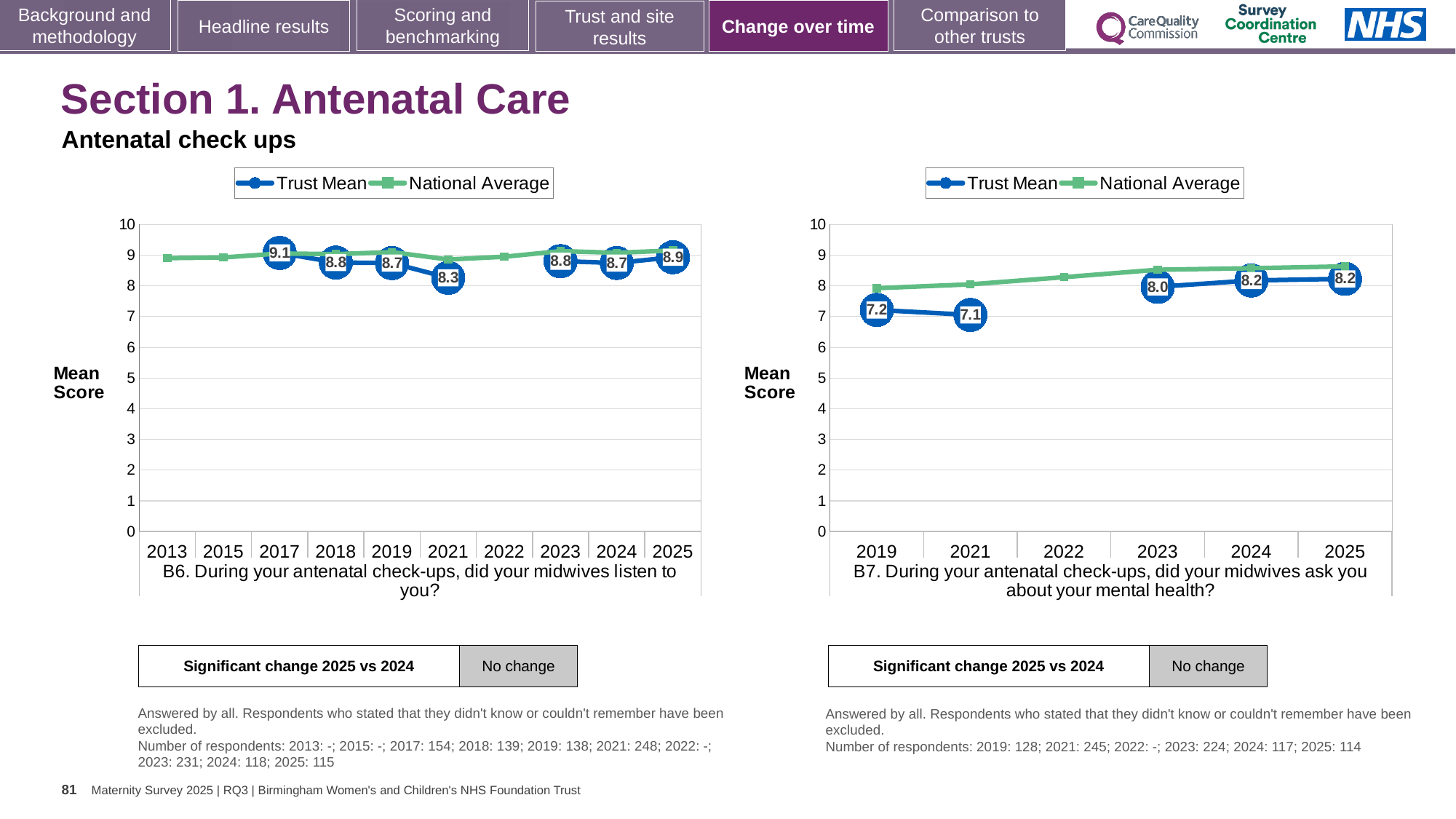
In the B7 chart (right), what is the Trust Mean for 2019? 7.2 In the B6 chart (left), which year has the highest labelled Trust Mean? 2017 In the B7 chart (right), is the National Average for 2019 greater or less than 7? greater In the B6 chart (left), what is the Trust Mean for 2025? 8.9 In the B6 chart (left), which year has the lowest labelled Trust Mean? 2021 How many series does the legend of the B7 chart (right) list? 2 In the B7 chart (right), what is the difference between the Trust Mean in 2025 and in 2021? 1.1 In the B6 chart (left), what is the difference between the Trust Mean in 2017 and in 2021? 0.8 In the B6 chart (left), what is the Trust Mean for 2021? 8.3 In the B6 chart (left), how many years are shown on the x axis? 10 In the B7 chart (right), is the Trust Mean for 2023 larger or smaller than the Trust Mean for 2021? larger In the B7 chart (right), which year has the lowest labelled Trust Mean? 2021